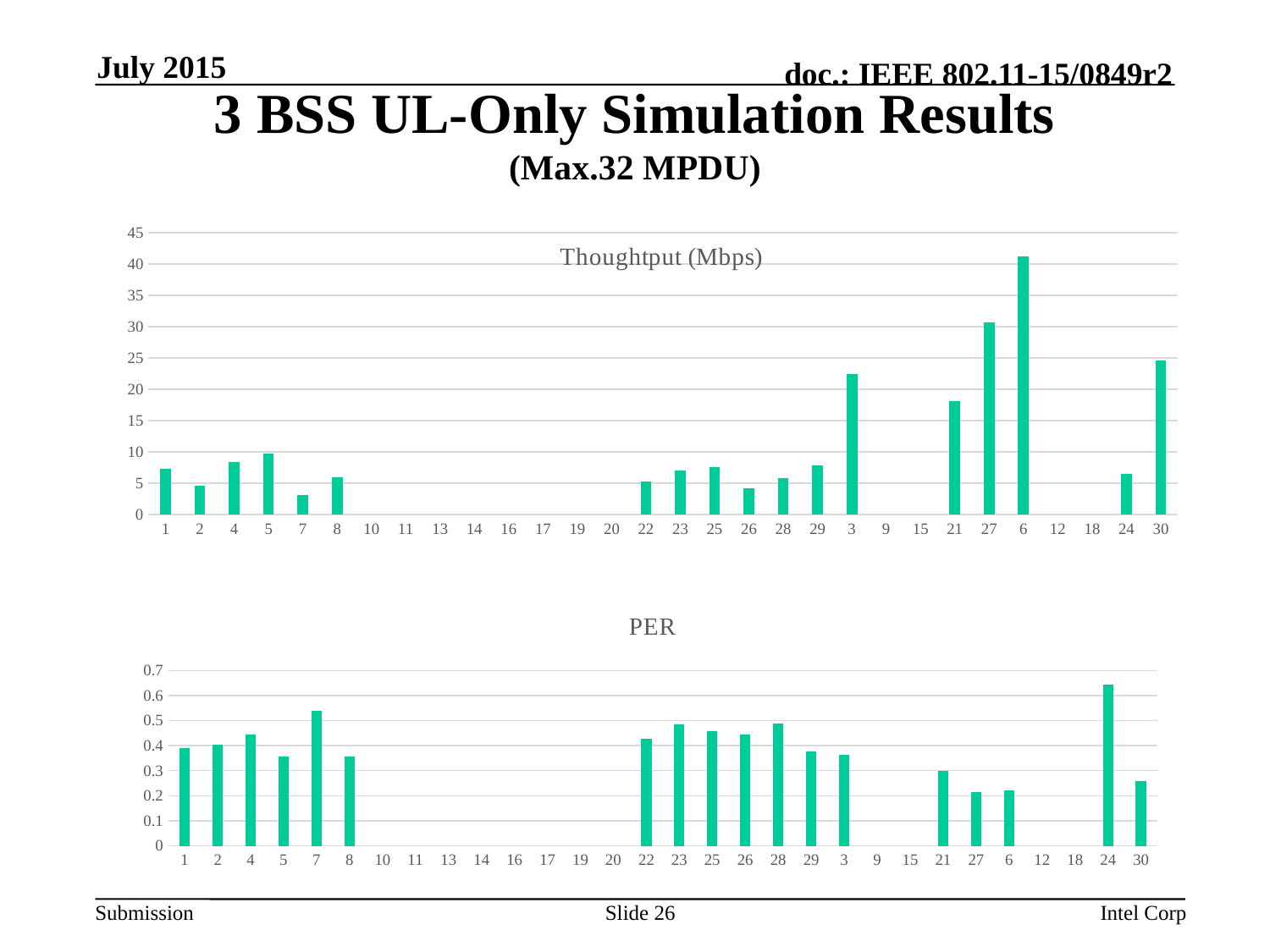
In the bottom chart (PER), which category has the highest bar? 24 How many categories are shown on the x axis of the bottom chart (PER)? 30 In the bottom chart (PER), is the value for category 27 greater or less than 0.3? less In the top chart (Thoughtput), is the value for category 7 greater or less than 5? less In the top chart (Thoughtput), is the value for category 3 greater or less than 20? greater In the top chart (Thoughtput), which category has the highest bar? 6 In the bottom chart (PER), which is larger, the value for category 7 or category 8? 7 What is the title of the bottom chart? PER What kind of chart is the top chart titled "Thoughtput (Mbps)"? bar chart In the top chart (Thoughtput), which is larger, the value for category 6 or category 27? 6